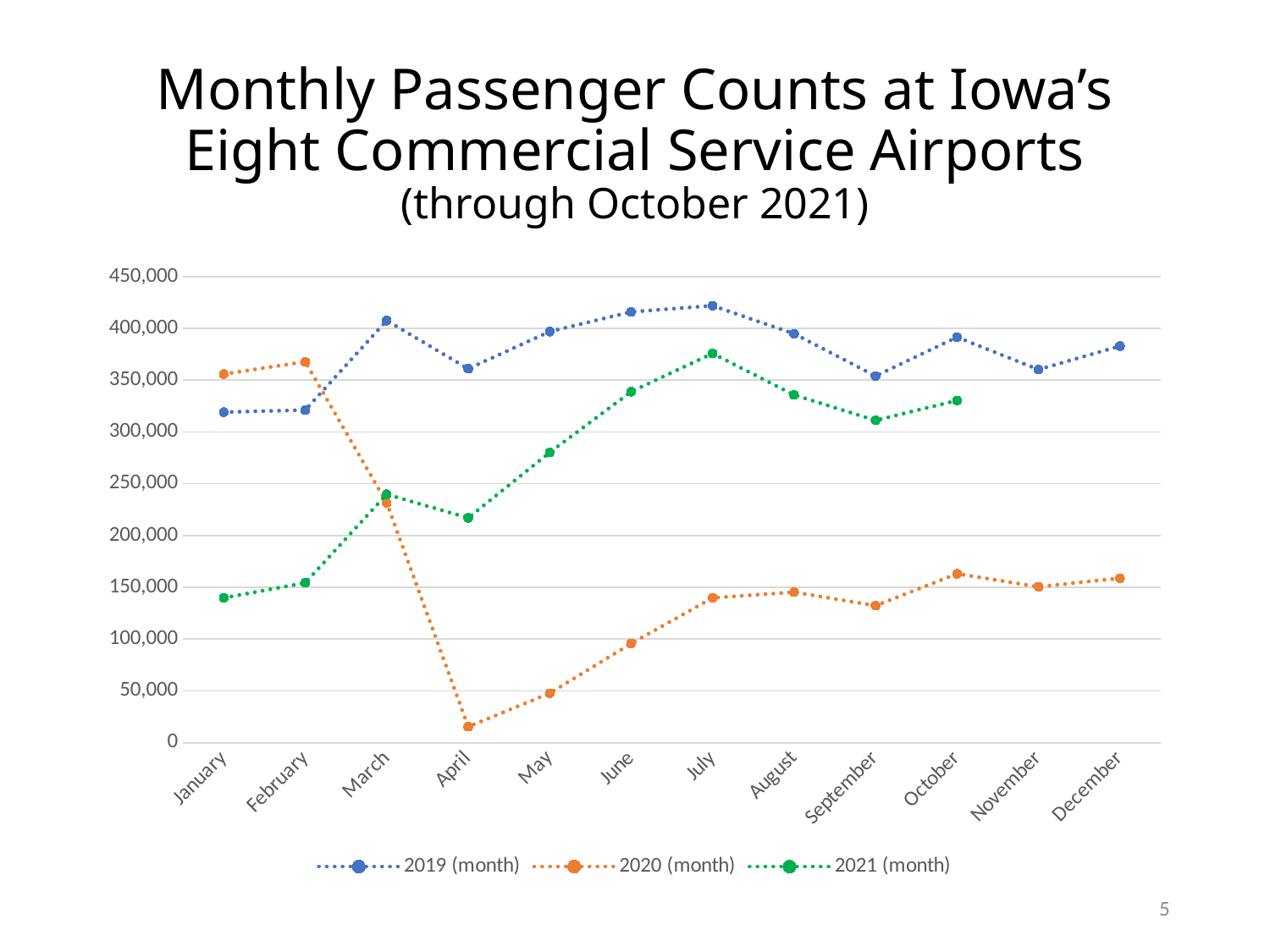
How many series does the legend list? 3 Is the value for 2019 (month) in July greater or less than 400,000? greater In which month is the 2020 (month) series at its highest? February In which month is the 2020 (month) series at its lowest? April What is the last month for which the 2021 (month) series has a data point? October What kind of chart is shown on the slide? Line chart How many months are shown along the x axis? 12 In January, which series has the higher value, 2019 (month) or 2020 (month)? 2020 (month) Does the 2020 (month) series rise or fall from February to April? Fall Is the value for 2020 (month) in April greater or less than 50,000? less Is the value for 2021 (month) in September greater or less than 300,000? greater In which month is the 2021 (month) series at its highest? July